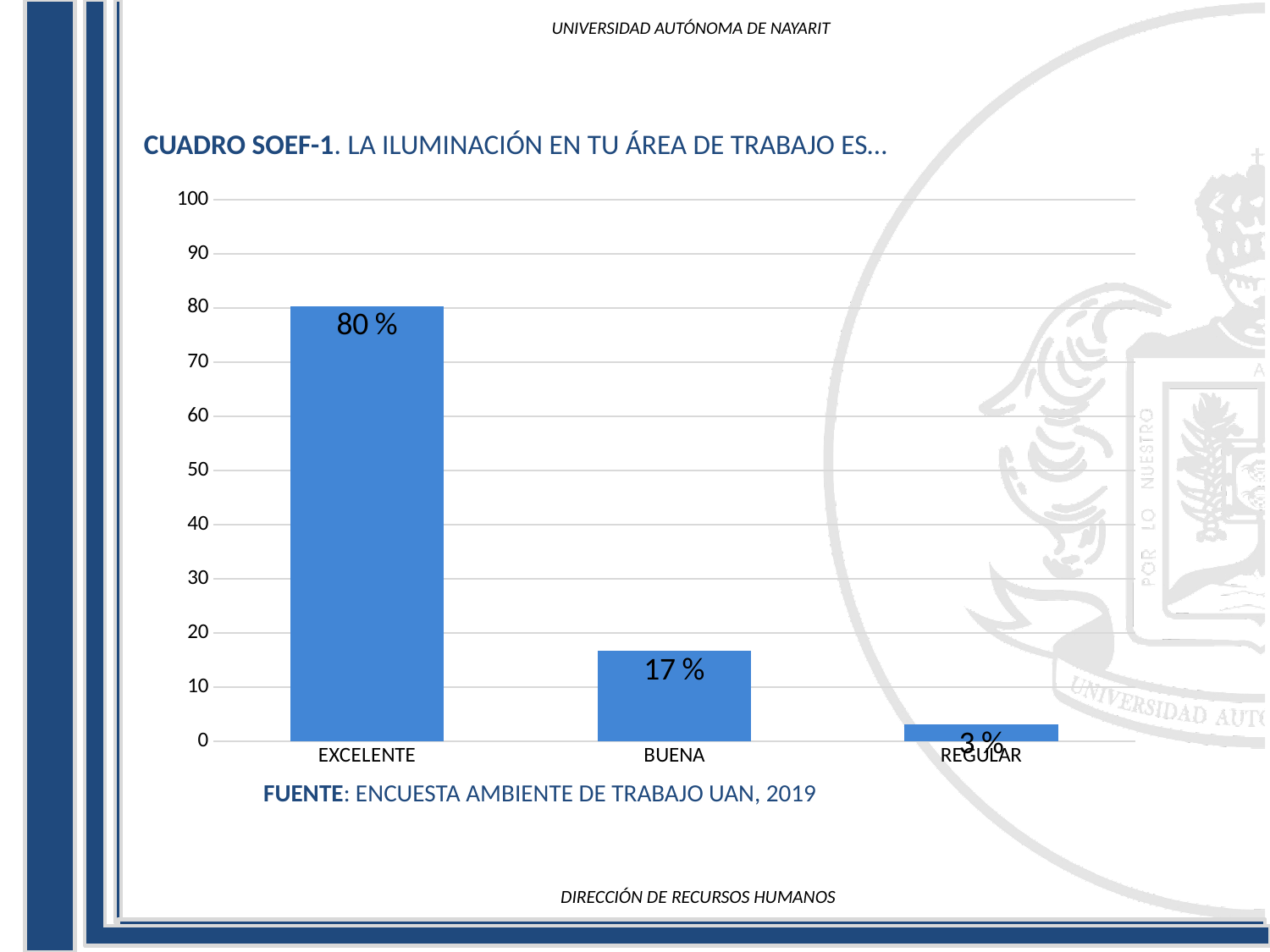
Which category has the lowest value? REGULAR What is the difference between the values for EXCELENTE and BUENA? 63 % What kind of chart is shown on the slide? bar chart Which is larger, the value for BUENA or the value for REGULAR? BUENA Is the value for EXCELENTE greater or less than 70? greater What is the value for EXCELENTE? 80 % Which category has the highest value? EXCELENTE What is the value for BUENA? 17 % What is the difference between the values for BUENA and REGULAR? 14 % What is the value for REGULAR? 3 % Do the values rise or fall from left to right along the x axis? fall How many categories are shown on the x axis? 3